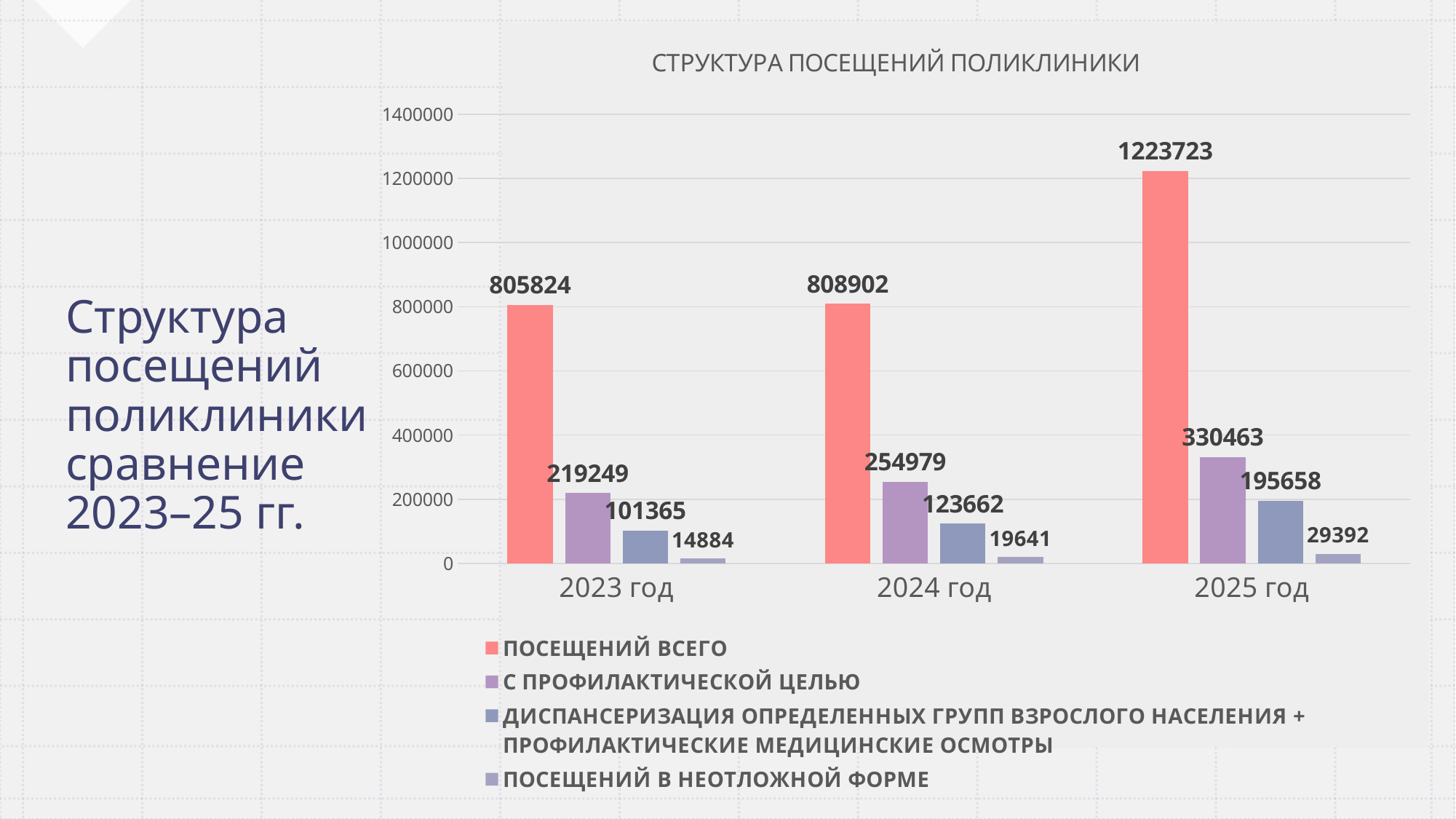
Что больше: посещения с профилактической целью в 2023 году или диспансеризация + профилактические медицинские осмотры в 2025 году? Посещения с профилактической целью в 2023 году Какое значение показателя «Посещений в неотложной форме» за 2023 год? 14884 В каком году показатель «Посещений в неотложной форме» был наименьшим? 2023 год В каком году показатель «Посещений всего» был наибольшим? 2025 год На сколько выросло общее число посещений в 2025 году по сравнению с 2024 годом? 414821 Как меняется показатель «Посещений в неотложной форме» с 2023 по 2025 год? Растёт На сколько число посещений с профилактической целью в 2025 году больше, чем в 2023 году? 111214 Какое значение показателя «Посещений всего» за 2025 год? 1223723 Сколько посещений по диспансеризации определенных групп взрослого населения + профилактическим медицинским осмотрам было в 2025 году? 195658 Какого типа диаграмма представлена на слайде? Столбчатая (bar chart) Сколько рядов данных указано в легенде диаграммы? 4 Сколько посещений с профилактической целью было в 2024 году? 254979